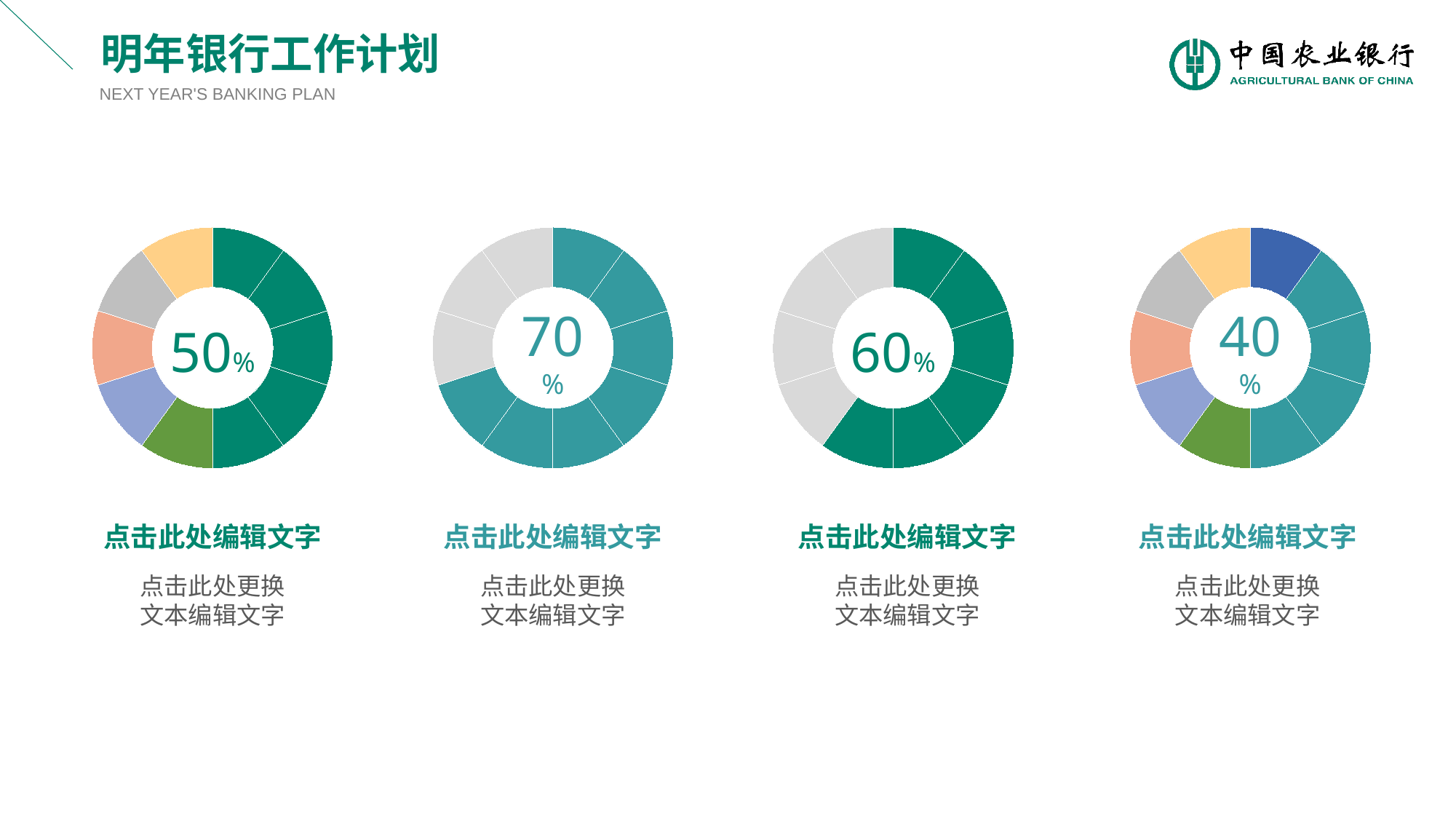
In the third donut chart from the left, what colour are the segments that are not green? Light grey Which of the four donut charts shows the highest centre percentage? The second from the left (70%) What kind of chart is used four times on this slide? Donut (ring) chart What percentage is shown in the centre of the first (leftmost) donut chart? 50% How many segments make up the ring of the second donut chart from the left? 10 Which of the four donut charts shows the lowest centre percentage? The rightmost (40%) What percentage is shown in the centre of the third donut chart from the left? 60% What is the difference between the centre value of the second donut chart (70%) and the fourth donut chart (40%)? 30 percentage points How many donut charts are on the slide? 4 Which is larger: the centre value of the first donut chart or the third donut chart? The third (60%) What percentage is shown in the centre of the fourth (rightmost) donut chart? 40% What percentage is shown in the centre of the second donut chart from the left? 70%